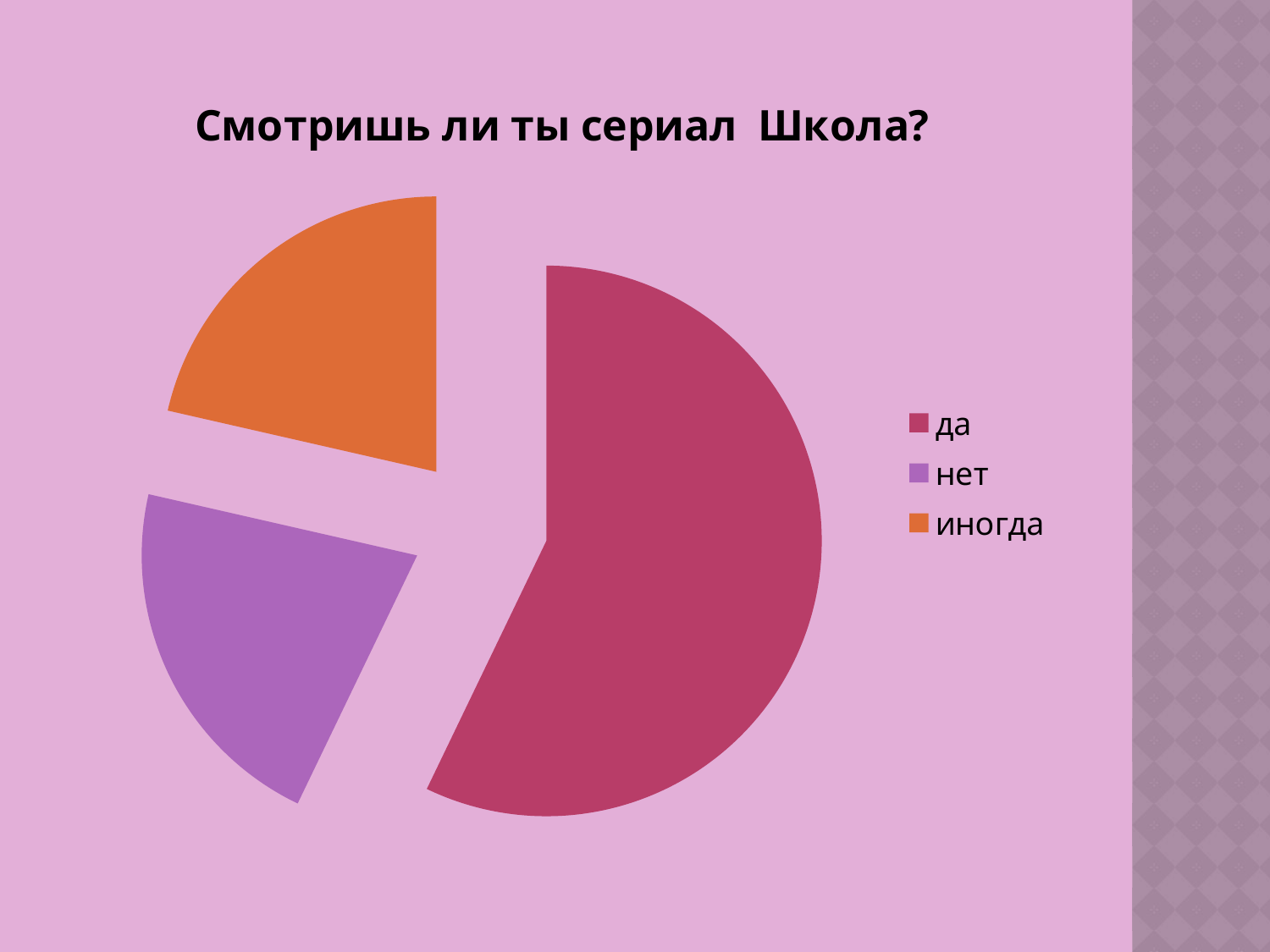
Which slice is larger, да or иногда? да What colour is the slice for иногда? orange Which slice is smaller, да or нет? нет How many slices does the pie chart have? 3 How many entries does the legend list? 3 Which category has the largest slice of the pie? да What kind of chart is shown on the slide? pie chart What is the title of the chart? Смотришь ли ты сериал Школа?